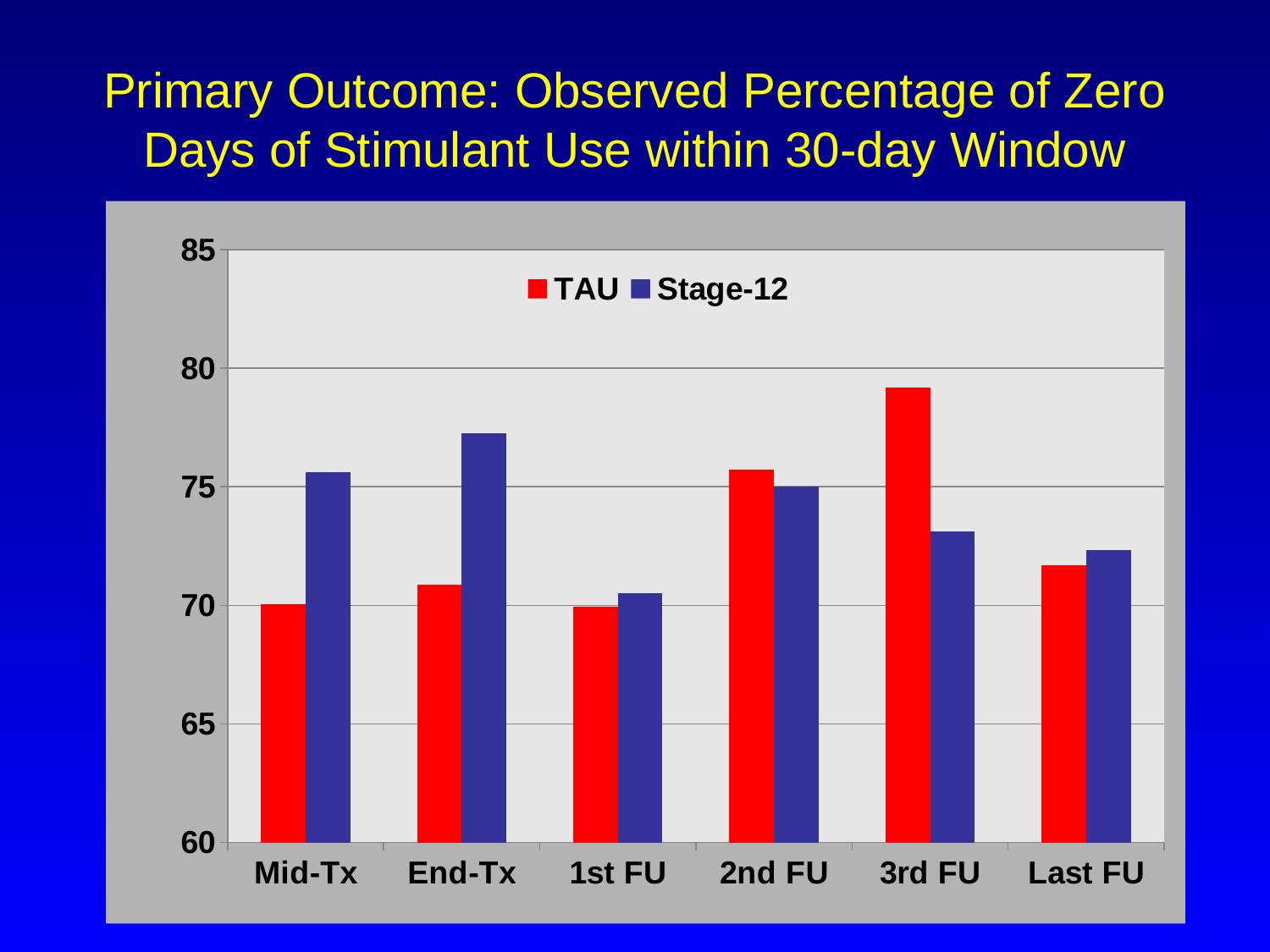
Is the TAU value at 3rd FU greater or less than 80? less How many time points (categories) are shown on the x axis? 6 At Mid-Tx, which series has the larger value, TAU or Stage-12? Stage-12 At 3rd FU, which series has the larger value, TAU or Stage-12? TAU At which time point is the TAU value highest? 3rd FU At which time point is the Stage-12 value highest? End-Tx At which time point is the Stage-12 value lowest? 1st FU What kind of chart is shown on the slide? bar chart Which colour represents the TAU series in the legend? red Is the TAU value at 3rd FU greater or less than 75? greater How many series does the legend list? 2 Is the Stage-12 value at 1st FU greater or less than 75? less